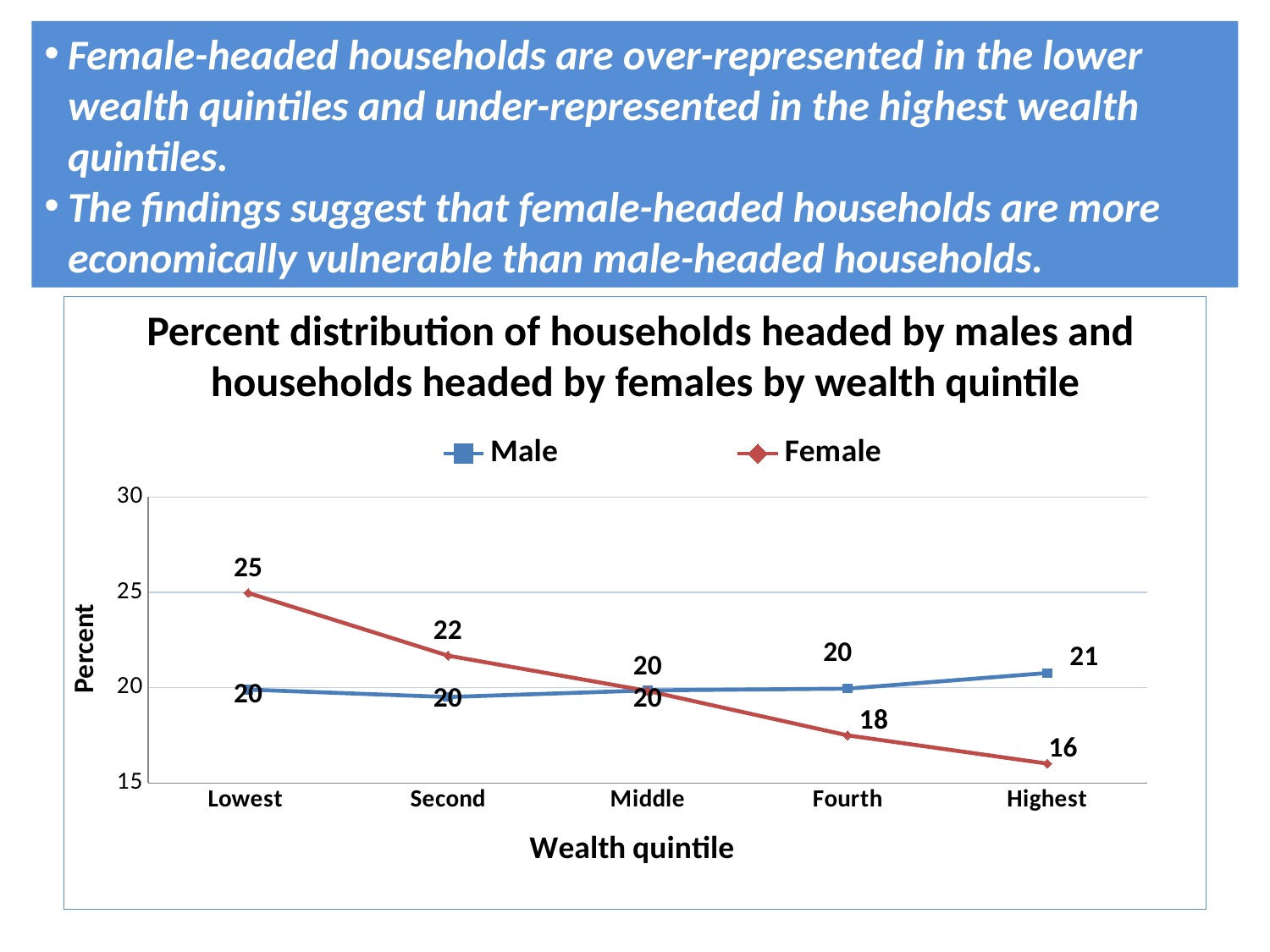
What kind of chart is shown on the slide? Line chart What is the Female value for the Highest wealth quintile? 16 How many wealth quintile categories are shown on the x axis? 5 Which wealth quintile has the lowest Female value? Highest What is the Female value for the Second wealth quintile? 22 For the Fourth wealth quintile, which series has the larger value, Male or Female? Male Does the Female series rise or fall from the Lowest to the Highest wealth quintile? Fall How many series does the legend list? 2 What is the Female value for the Lowest wealth quintile? 25 Which wealth quintile has the highest Female value? Lowest What is the difference between the Female and Male values for the Lowest wealth quintile? 5 What is the Male value for the Highest wealth quintile? 21